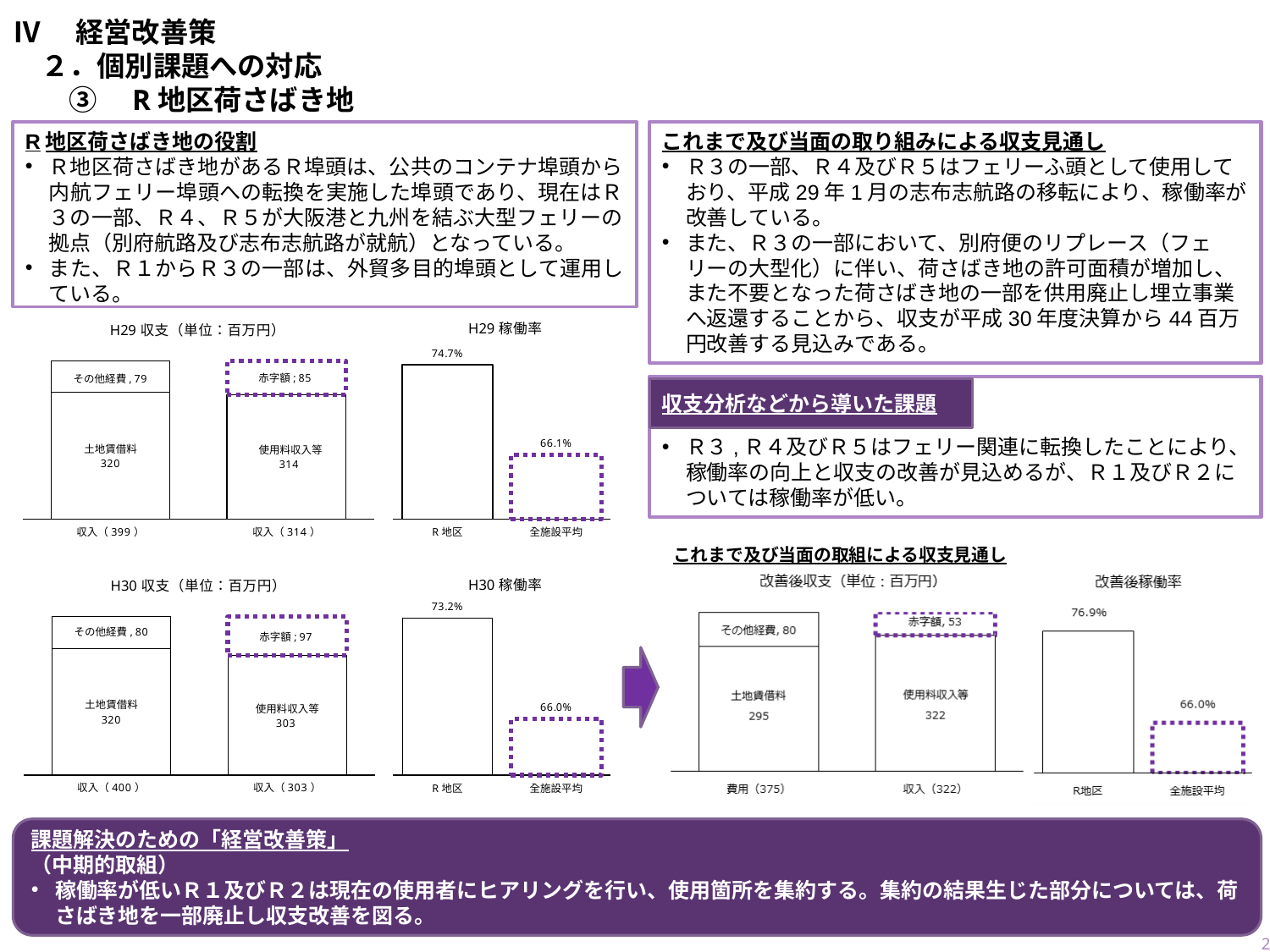
In the H30 収支 chart, what is the value of 使用料収入等? 303 In the H29 収支 chart, what is the total of the left stacked bar (その他経費 plus 土地賃借料)? 399 In the H30 収支 chart, what is the value of 土地賃借料? 320 In the H29 稼働率 chart, what is the value for R地区? 74.7% In the H30 稼働率 chart, what is the value for 全施設平均? 66.0% In the 改善後収支 chart, what is the value of 赤字額? 53 In the 改善後稼働率 chart, what is the value for R地区? 76.9% In the H30 稼働率 chart, which category is higher, R地区 or 全施設平均? R地区 In the 改善後収支 chart, what is the difference between 使用料収入等 and 土地賃借料? 27 In the H29 収支 chart, what is the value of 赤字額? 85 In the H29 稼働率 chart, what is the difference between R地区 and 全施設平均? 8.6% What kind of chart is the 改善後稼働率 chart? Bar chart